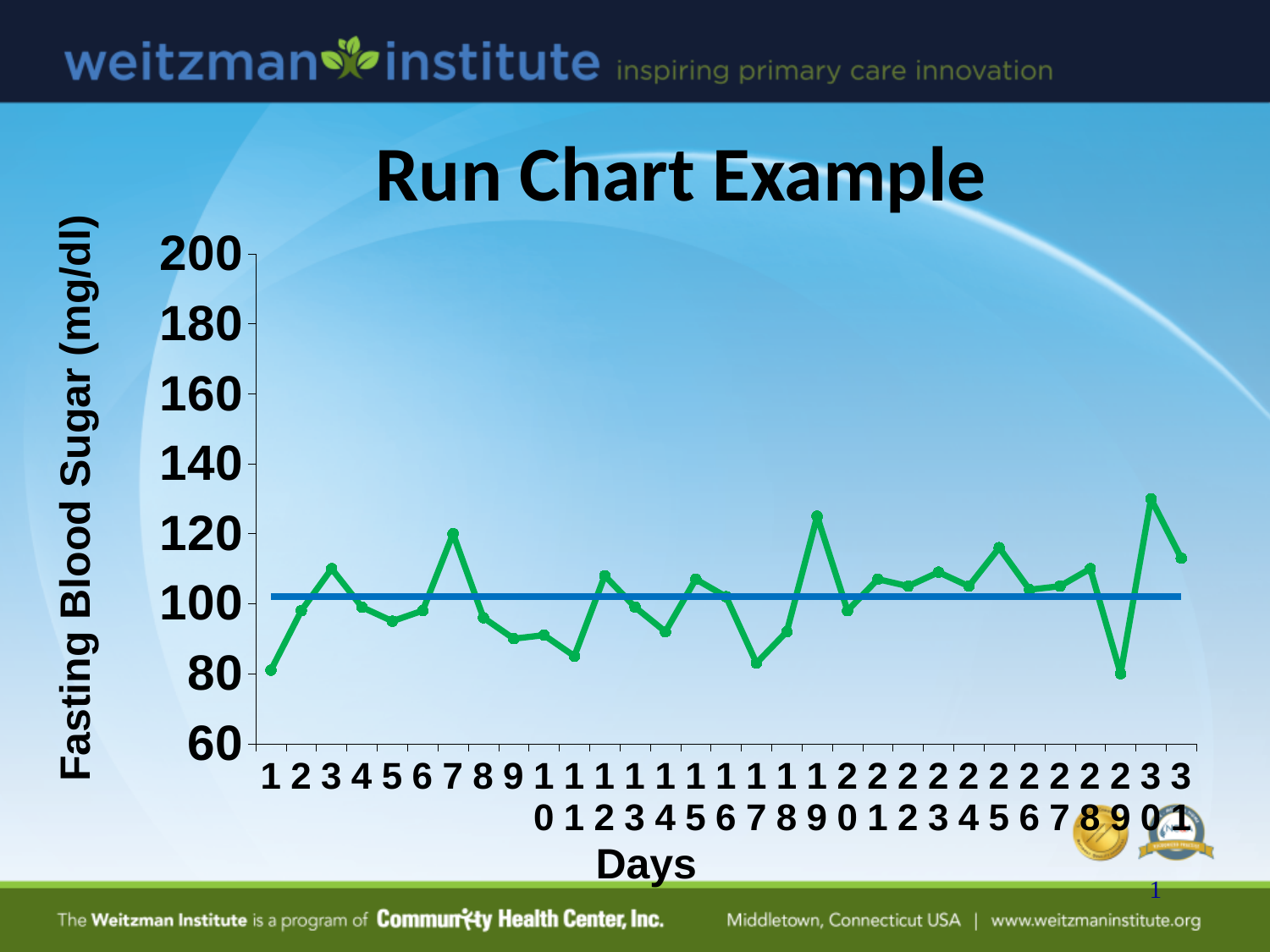
On which day is the fasting blood sugar highest? 30 Which has the higher fasting blood sugar, day 19 or day 13? day 19 Does the fasting blood sugar rise or fall from day 30 to day 31? fall Which has the higher fasting blood sugar, day 7 or day 29? day 7 What kind of chart is shown on the slide? line chart How many days are plotted on the chart? 31 Is the value for day 18 greater or less than 100? less Is the value for day 29 greater or less than 100? less Is the value for day 30 greater or less than 120? greater What is the label of the vertical axis? Fasting Blood Sugar (mg/dl) What is the title of the chart? Run Chart Example